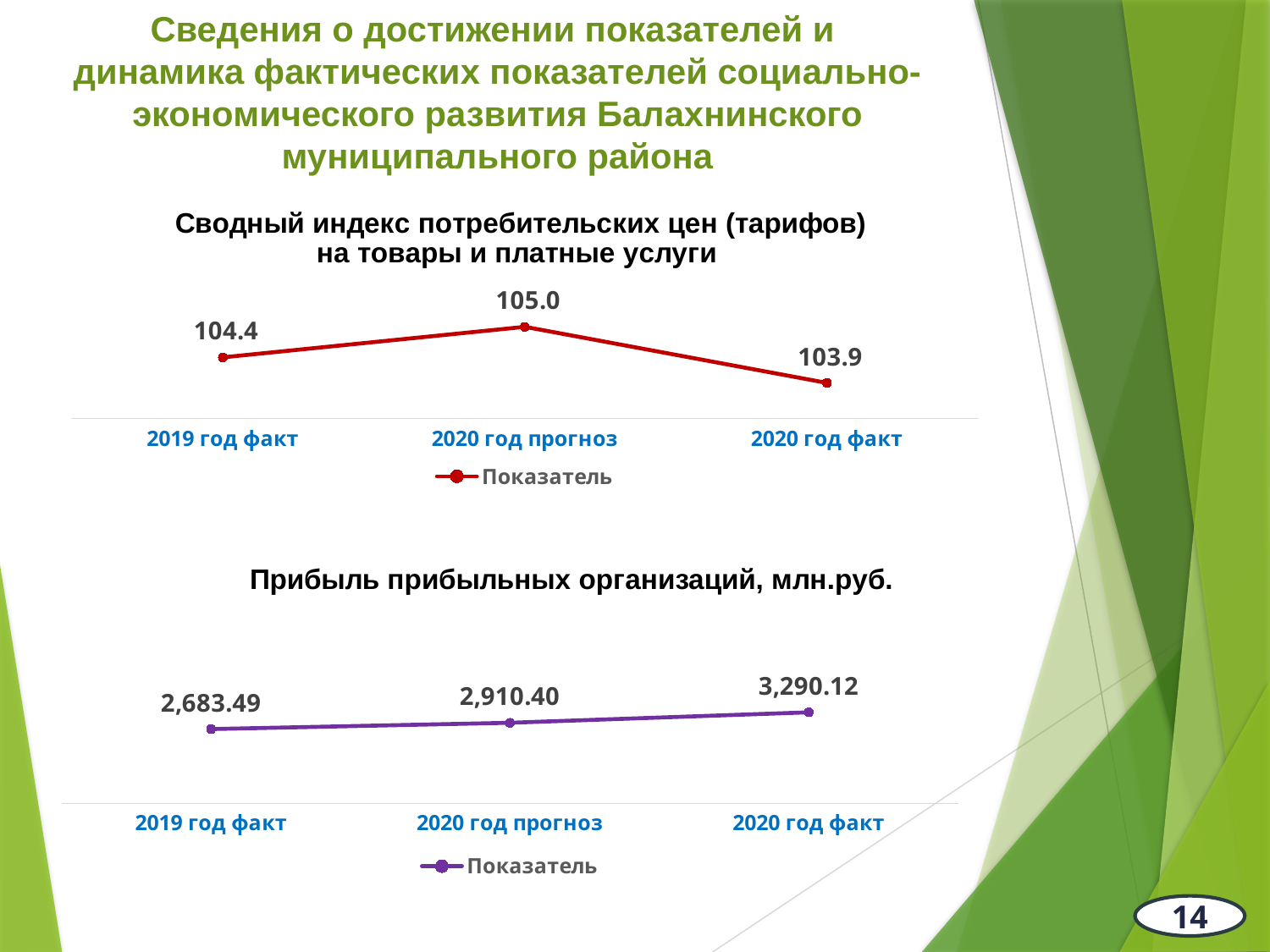
In the bottom chart (Прибыль прибыльных организаций), what is the value for 2019 год факт? 2,683.49 In the top chart (Сводный индекс потребительских цен), what is the difference between the 2020 год прогноз value and the 2020 год факт value? 1.1 In the top chart (Сводный индекс потребительских цен), what is the value for 2020 год факт? 103.9 In the top chart (Сводный индекс потребительских цен), what is the value for 2020 год прогноз? 105.0 In the bottom chart (Прибыль прибыльных организаций), which category has the highest value? 2020 год факт What kind of chart is the bottom chart (Прибыль прибыльных организаций)? line chart In the bottom chart (Прибыль прибыльных организаций), what is the difference between the 2020 год факт value and the 2020 год прогноз value? 379.72 In the bottom chart (Прибыль прибыльных организаций), what is the value for 2020 год факт? 3,290.12 How many data points are plotted in the top chart (Сводный индекс потребительских цен)? 3 In the top chart (Сводный индекс потребительских цен), which category has the lowest value? 2020 год факт In the top chart (Сводный индекс потребительских цен), which is larger: the value for 2019 год факт or for 2020 год факт? 2019 год факт In the bottom chart (Прибыль прибыльных организаций), do the values rise or fall from left to right? rise